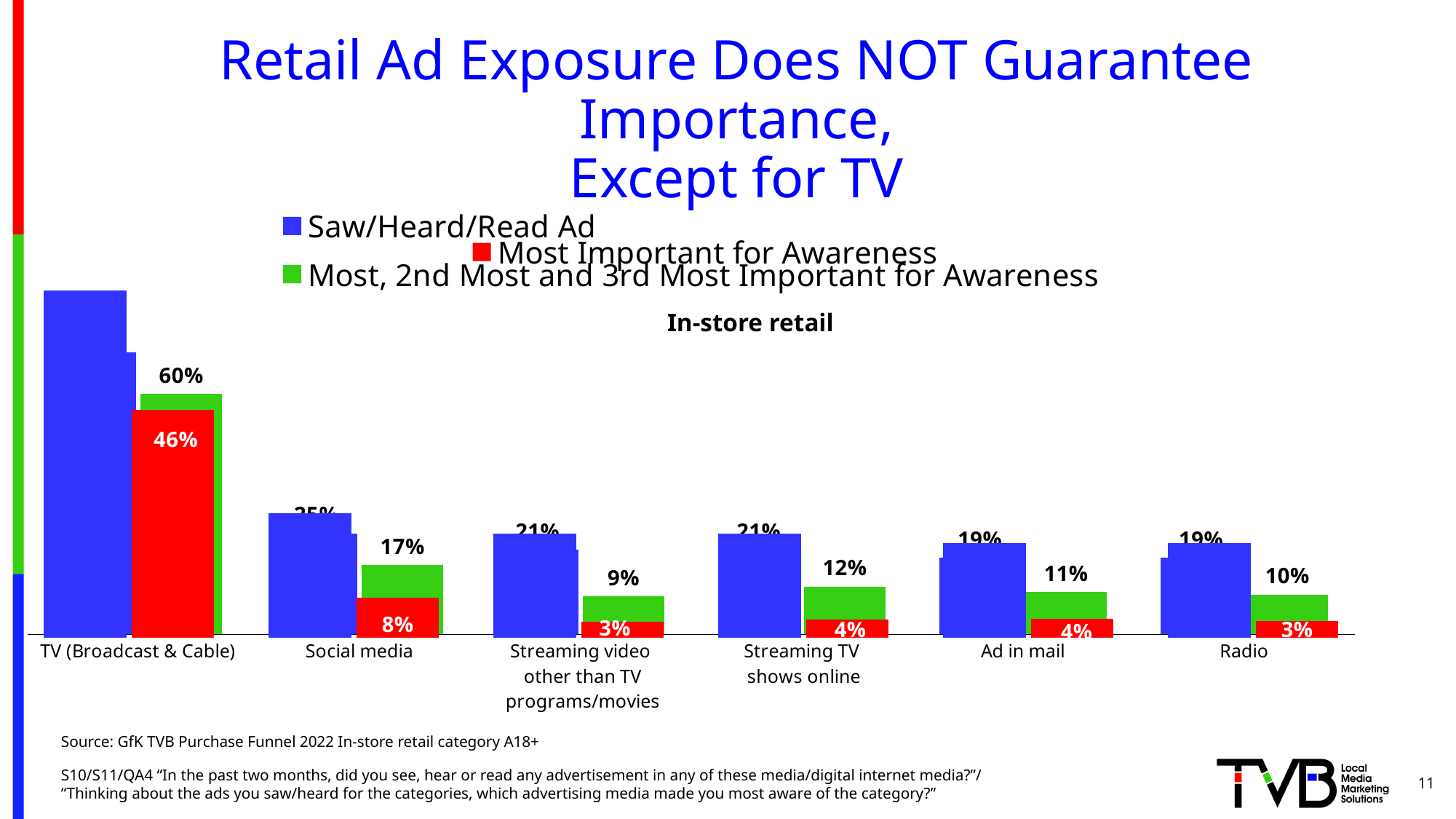
Which category has the highest 'Most Important for Awareness' value? TV (Broadcast & Cable) What is the 'Most Important for Awareness' value for Social media? 8% What is the 'Most Important for Awareness' value for Radio? 3% How many media categories are shown along the x axis of the chart? 6 What is the 'Most Important for Awareness' value for TV (Broadcast & Cable)? 46% For TV (Broadcast & Cable), what is the difference between the 'Most, 2nd Most and 3rd Most Important for Awareness' value and the 'Most Important for Awareness' value? 14 percentage points What kind of chart is shown on the slide? Bar chart Which category has the lowest 'Most, 2nd Most and 3rd Most Important for Awareness' value? Streaming video other than TV programs/movies What is the title printed above the chart? In-store retail How many series does the chart legend list? 3 What is the 'Most, 2nd Most and 3rd Most Important for Awareness' value for Social media? 17% What is the 'Most, 2nd Most and 3rd Most Important for Awareness' value for TV (Broadcast & Cable)? 60%